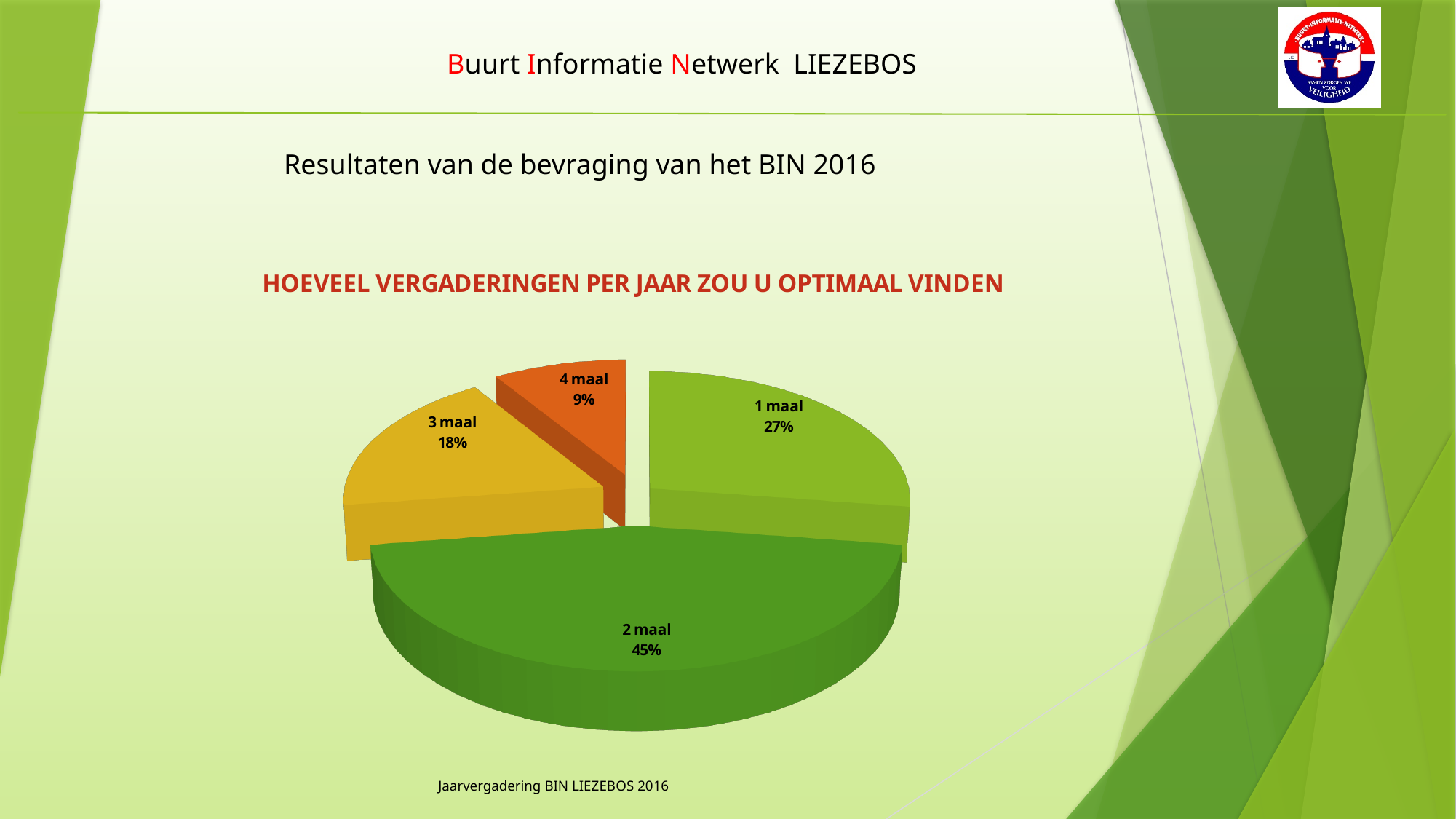
Which category has the smallest slice of the pie? 4 maal What is the value shown for "4 maal"? 9% What share of the pie does the "2 maal" slice represent? 45% What share of the pie does the "1 maal" slice represent? 27% What is the difference in percentage points between "2 maal" and "1 maal"? 18 What kind of chart is shown on the slide? Pie chart Which category has the largest slice of the pie? 2 maal Which is larger, the slice for "1 maal" or the slice for "3 maal"? 1 maal What is the value shown for "3 maal"? 18% What is the difference in percentage points between "3 maal" and "4 maal"? 9 What is the title of the chart? HOEVEEL VERGADERINGEN PER JAAR ZOU U OPTIMAAL VINDEN How many categories are shown in the pie chart? 4